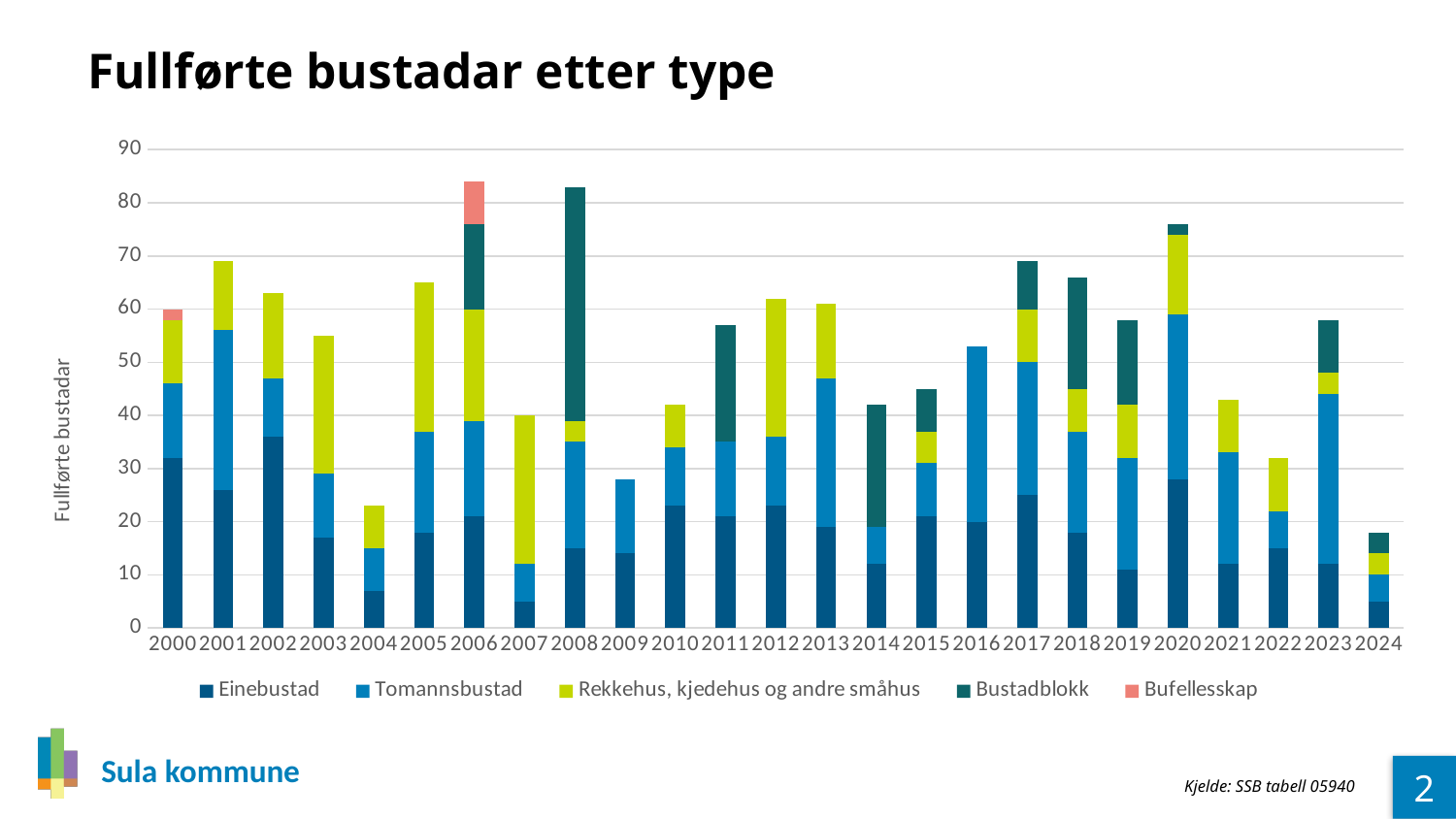
Which year has the largest Bustadblokk segment? 2008 How many years are shown along the x axis? 25 Which year has the larger total, 2013 or 2014? 2013 What is the title of the chart? Fullførte bustadar etter type Is the total for 2009 greater or less than 30? less Is the total for 2024 greater or less than 20? less How many series does the legend list? 5 Which year has the lowest total of completed dwellings? 2024 Is the total for 2016 greater or less than 50? greater What type of chart is shown on the slide? Stacked bar chart What is the label on the vertical axis? Fullførte bustadar